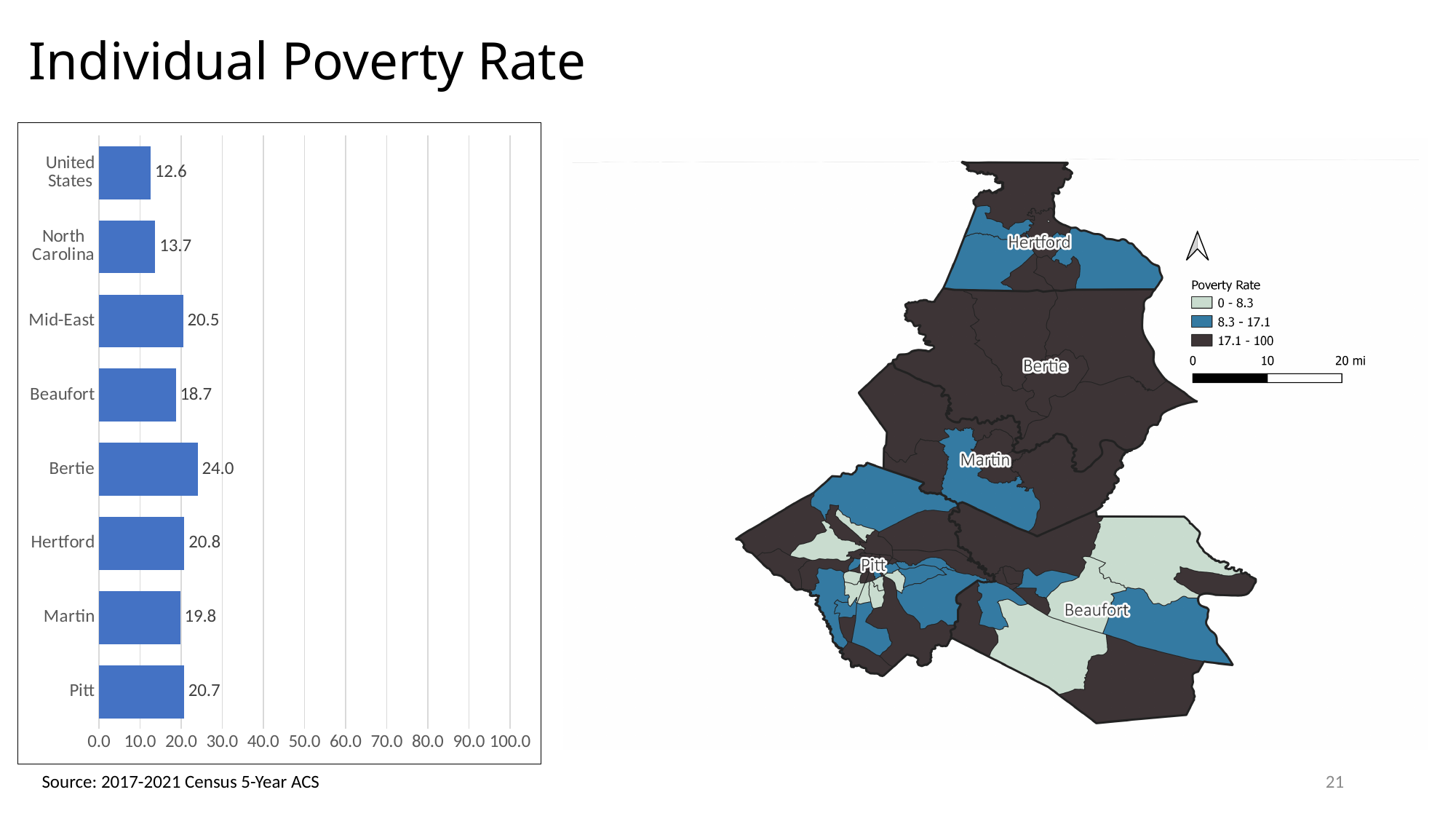
What kind of chart is shown on the left of the slide? Bar chart What is the individual poverty rate for the United States in the bar chart? 12.6 What is the difference between the poverty rates of Bertie and North Carolina in the bar chart? 10.3 Which has a higher poverty rate in the bar chart, Beaufort or Hertford? Hertford What is the highest value shown on the x axis of the bar chart? 100.0 What is the difference between the poverty rates of Mid-East and Pitt in the bar chart? 0.2 Which category has the lowest individual poverty rate in the bar chart? United States Is the value for Pitt in the bar chart greater or less than 30.0? less How many categories are shown in the bar chart? 8 What is the individual poverty rate for Martin in the bar chart? 19.8 Which category has the highest individual poverty rate in the bar chart? Bertie What is the individual poverty rate for Bertie in the bar chart? 24.0